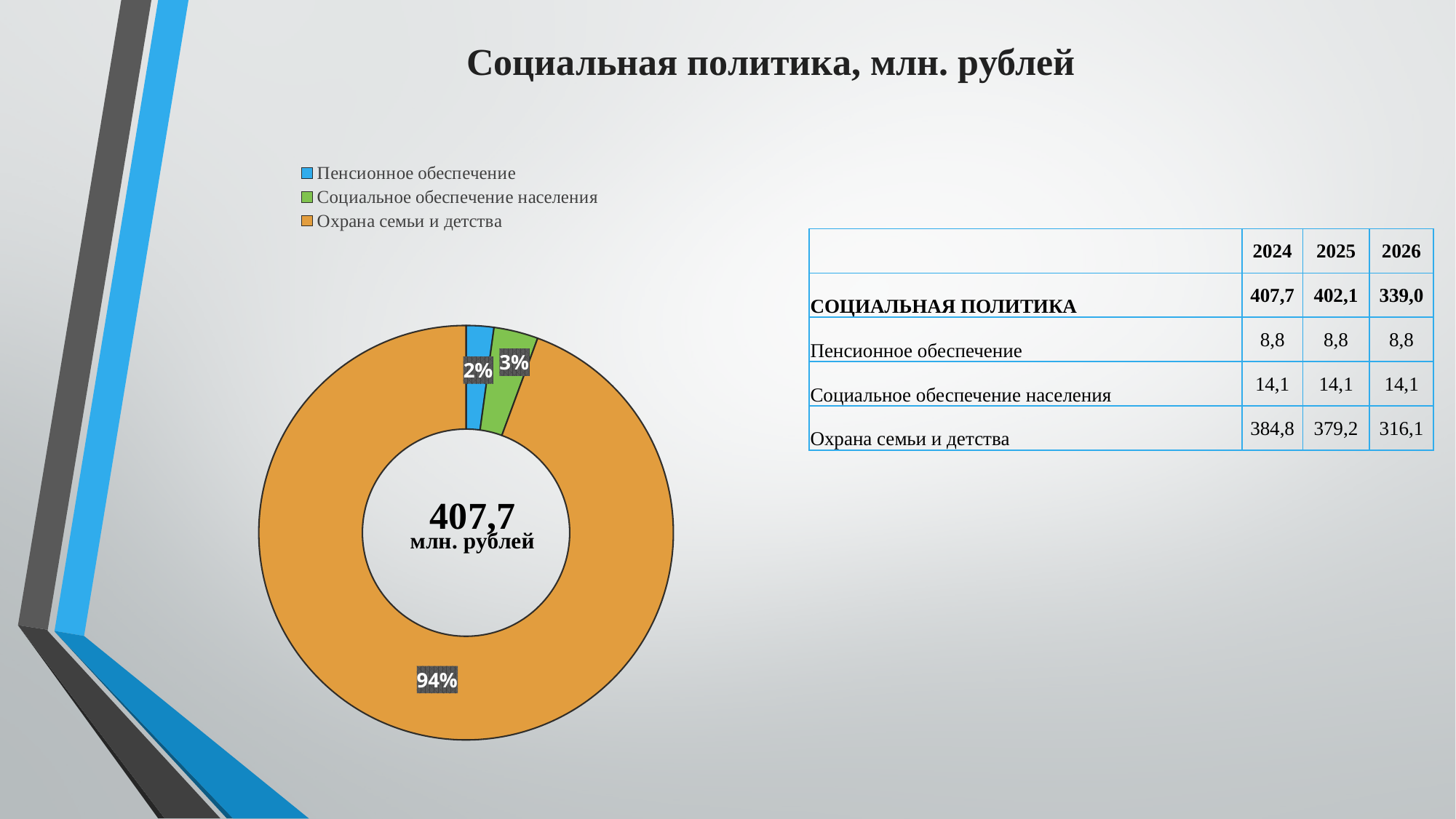
What is the difference in percentage points between the Охрана семьи и детства slice and the Социальное обеспечение населения slice? 91 percentage points Which category has the largest slice in the doughnut chart? Охрана семьи и детства How many categories (slices) does the doughnut chart have? 3 What share of the doughnut chart does Социальное обеспечение населения take? 3% Which category has the smallest slice in the doughnut chart? Пенсионное обеспечение What share of the doughnut chart does Пенсионное обеспечение take? 2% What colour is the Охрана семьи и детства slice in the doughnut chart? Orange What kind of chart is shown on the slide? Doughnut (pie) chart Which slice is larger in the doughnut chart: Пенсионное обеспечение or Социальное обеспечение населения? Социальное обеспечение населения How many entries does the legend of the doughnut chart list? 3 What share of the doughnut chart does Охрана семьи и детства take? 94% What total value is printed in the centre of the doughnut chart? 407,7 млн. рублей